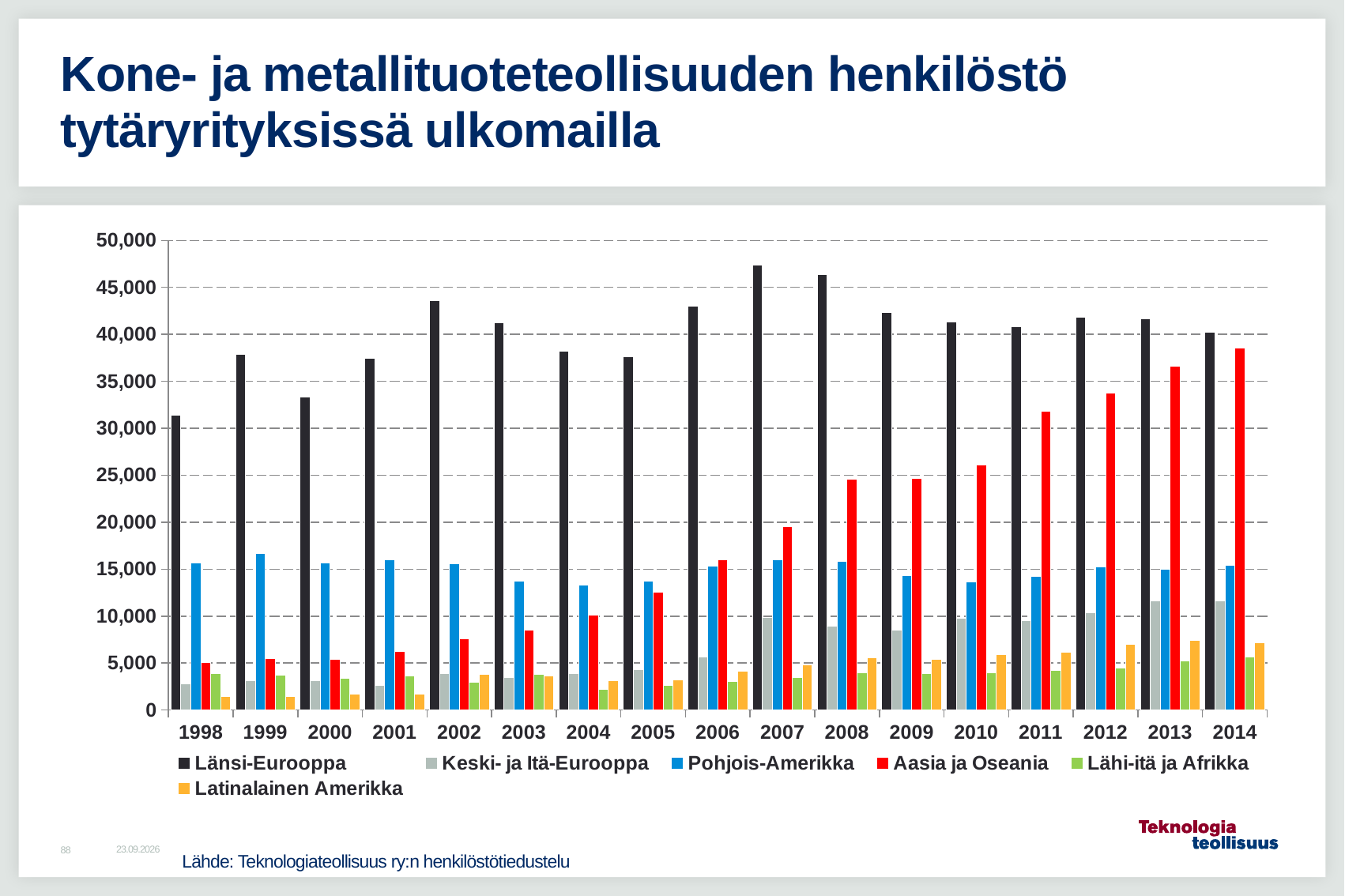
In which year is the value for Aasia ja Oseania highest? 2014 What kind of chart is shown on the slide? bar chart In 2007, which is larger: Aasia ja Oseania or Pohjois-Amerikka? Aasia ja Oseania In which year is the value for Länsi-Eurooppa lowest? 1998 How many series does the legend list? 6 Does the value for Aasia ja Oseania generally rise or fall from 1998 to 2014? rise How many years are shown on the x axis? 17 Is the value for Aasia ja Oseania in 2011 greater or less than 30,000? greater Is the value for Länsi-Eurooppa in 2007 greater or less than 45,000? greater In 2014, which is larger: Länsi-Eurooppa or Aasia ja Oseania? Länsi-Eurooppa Is the value for Latinalainen Amerikka in 1998 greater or less than 5,000? less In which year is the value for Länsi-Eurooppa highest? 2007